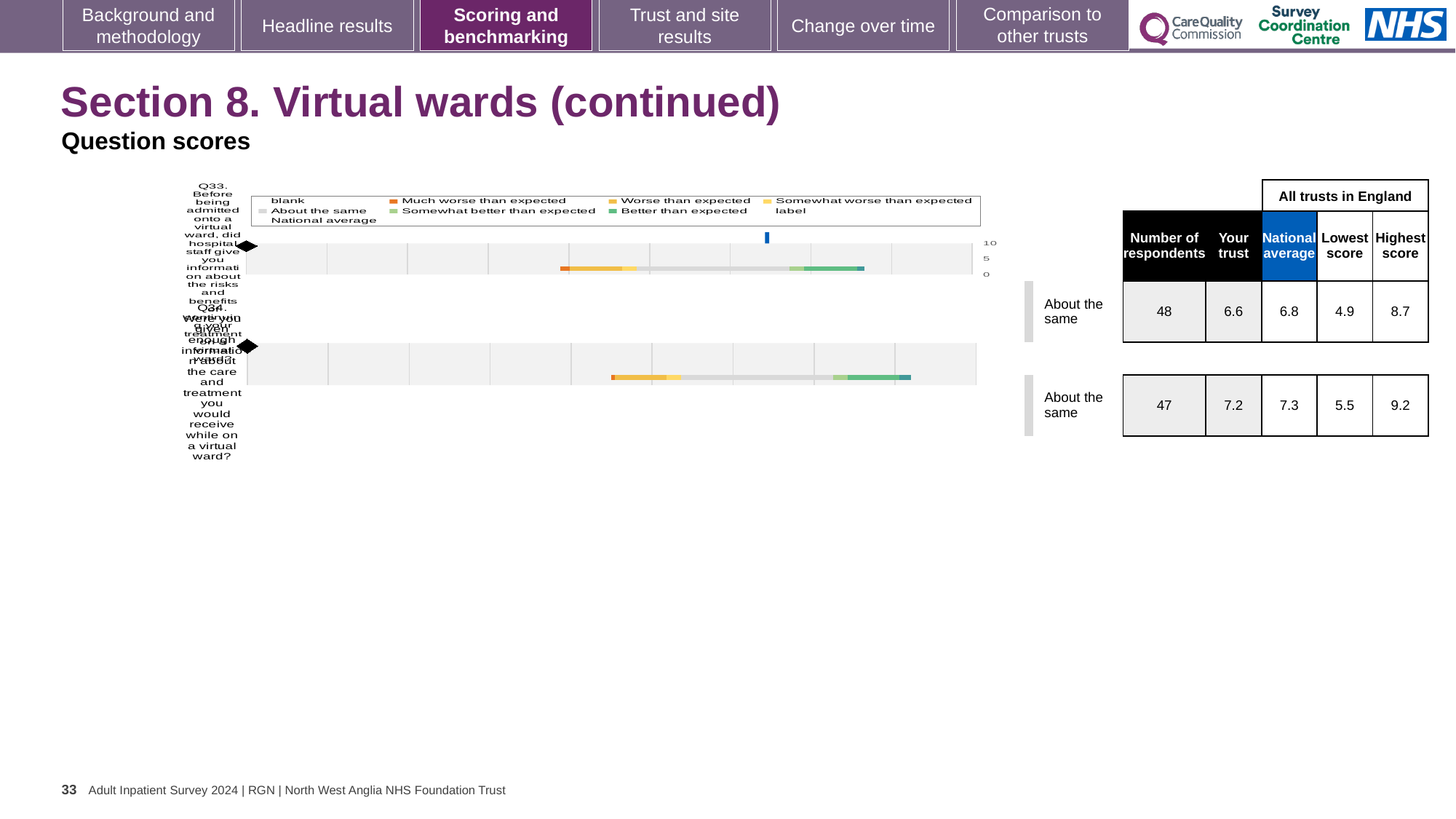
What is the difference between the national average and the 'Your trust' score for Q34? 0.1 How many questions (bars) are plotted in the chart? 2 What is the difference between the highest and lowest scores for Q34? 3.7 What is the lowest score among all trusts in England for Q33? 4.9 What is the national average score for Q34? 7.3 Which is larger for Q33, the 'Your trust' score or the national average? National average What benchmark category is shown for Q34? About the same What is the 'Your trust' score for Q33? 6.6 What is the highest score among all trusts in England for Q34? 9.2 How many respondents answered Q33? 48 What kind of chart is used to show the question scores for Q33 and Q34? bar chart